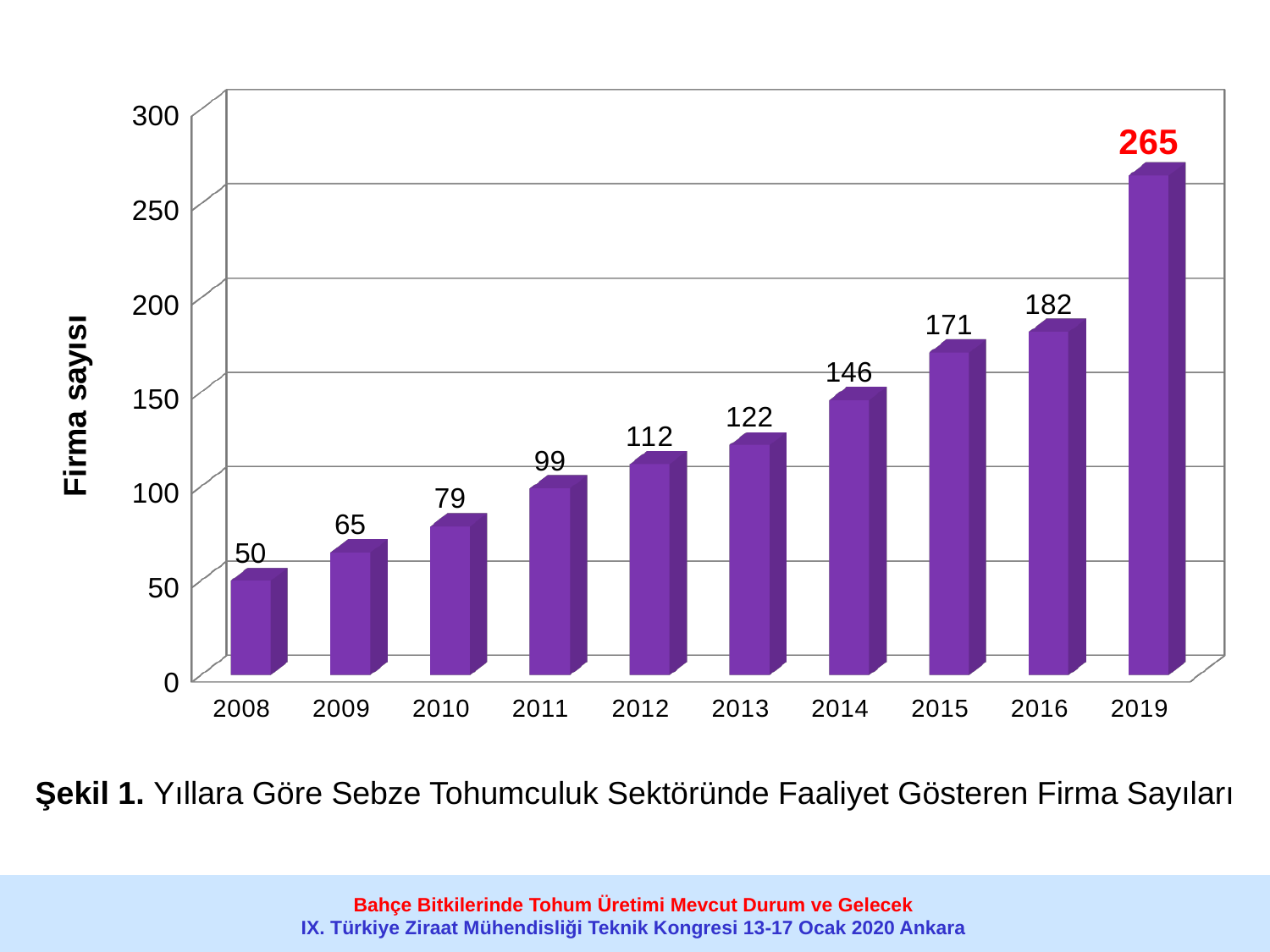
Which is larger, the value for 2013 or the value for 2011? 2013 How many years are shown on the x axis? 10 What is the value shown for 2008? 50 Which year has the lowest number of firms? 2008 What is the value shown for 2019? 265 What is the difference between the values for 2015 and 2014? 25 What is the difference between the values for 2019 and 2016? 83 Which year has the highest number of firms? 2019 Do the values rise or fall from 2008 to 2019? rise What is the number of firms (Firma sayısı) in 2012? 112 Is the value for 2014 greater or less than 150? less What kind of chart is shown on the slide? bar chart